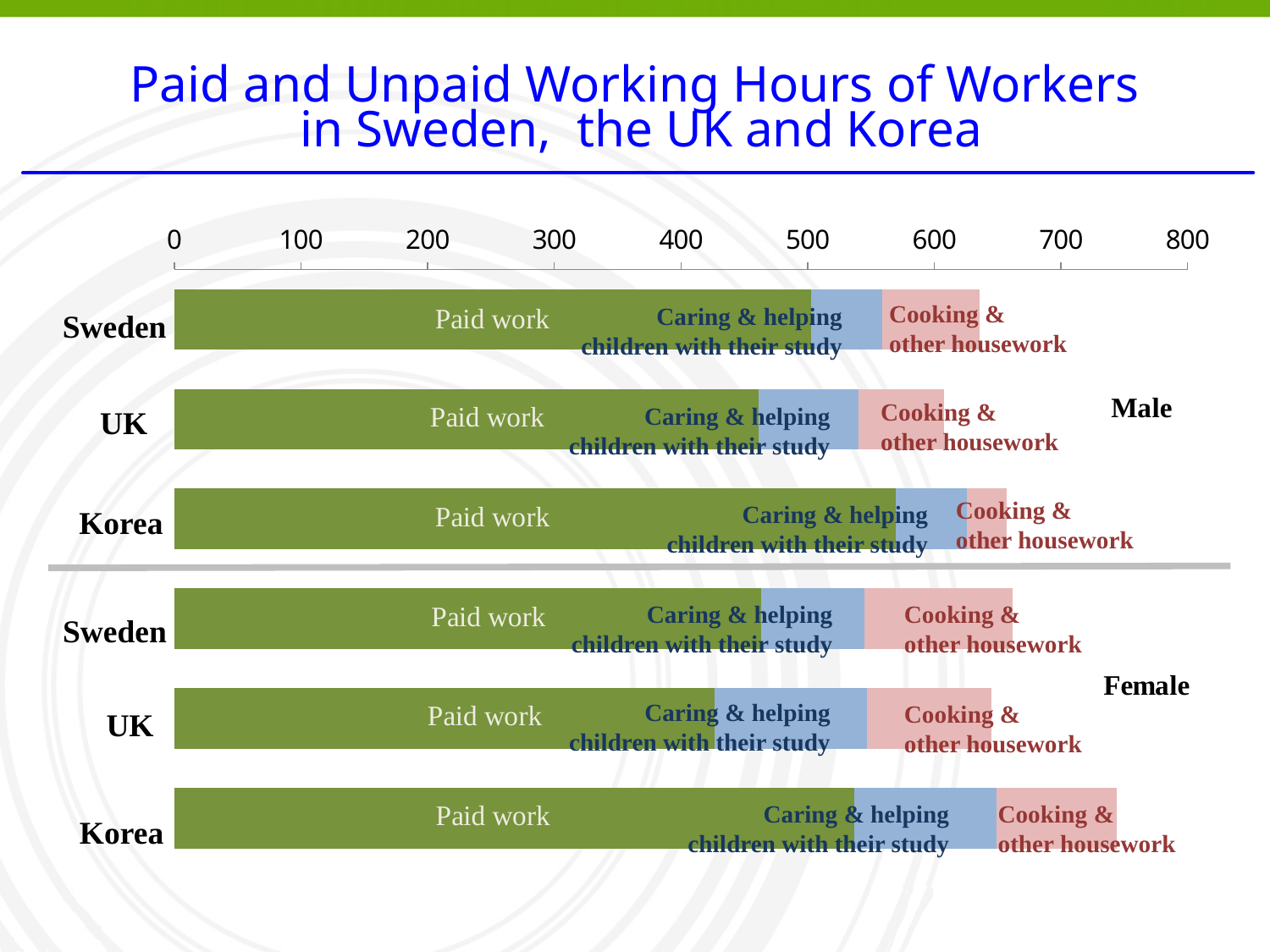
How many types of work is each bar divided into? 3 Is the total length of the Korea (Female) bar greater or less than 700? greater Which bar has the longest total length? Korea (Female) How many bars does the chart contain? 6 What kind of chart is shown on the slide? Stacked horizontal bar chart Is the total length of the Korea (Male) bar greater or less than 700? less Which bar has the longest Paid work segment? Korea (Male) Is the Paid work value for UK (Female) greater or less than 500? less Which bar has the shortest Paid work segment? UK (Female) Which colour represents the Paid work segment in the bars? Green Which is larger, the Paid work segment for Korea (Male) or for UK (Male)? Korea (Male)